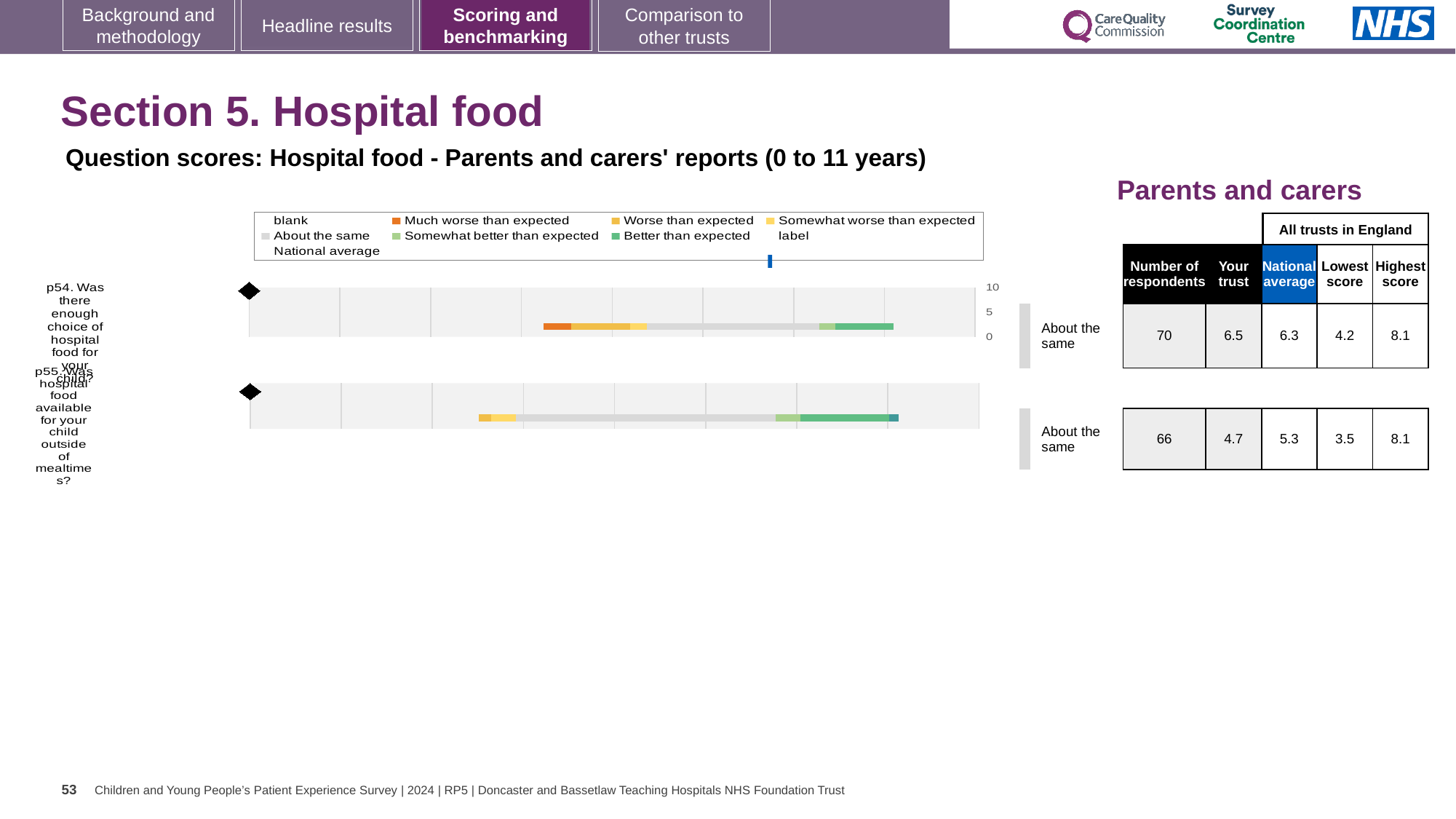
What kind of chart is used to show the question scores for p54 and p55? bar chart For p55, which is larger: the 'Your trust' score or the national average? National average In the table beside the chart, what is the lowest score across all trusts in England for p55? 3.5 In the table beside the chart, what is the 'Your trust' score for p54 (enough choice of hospital food)? 6.5 In the table beside the chart, what is the national average for p54? 6.3 What benchmark category is shown next to the chart for p54? About the same How many questions (categories) are plotted in the chart? 2 What is the maximum value shown on the chart's score axis? 10 In the table beside the chart, what is the 'Your trust' score for p55 (food available outside of mealtimes)? 4.7 What is the difference between the highest and lowest trust scores for p54? 3.9 How many respondents answered p55? 66 Which colour does the legend use for 'Much worse than expected'? orange